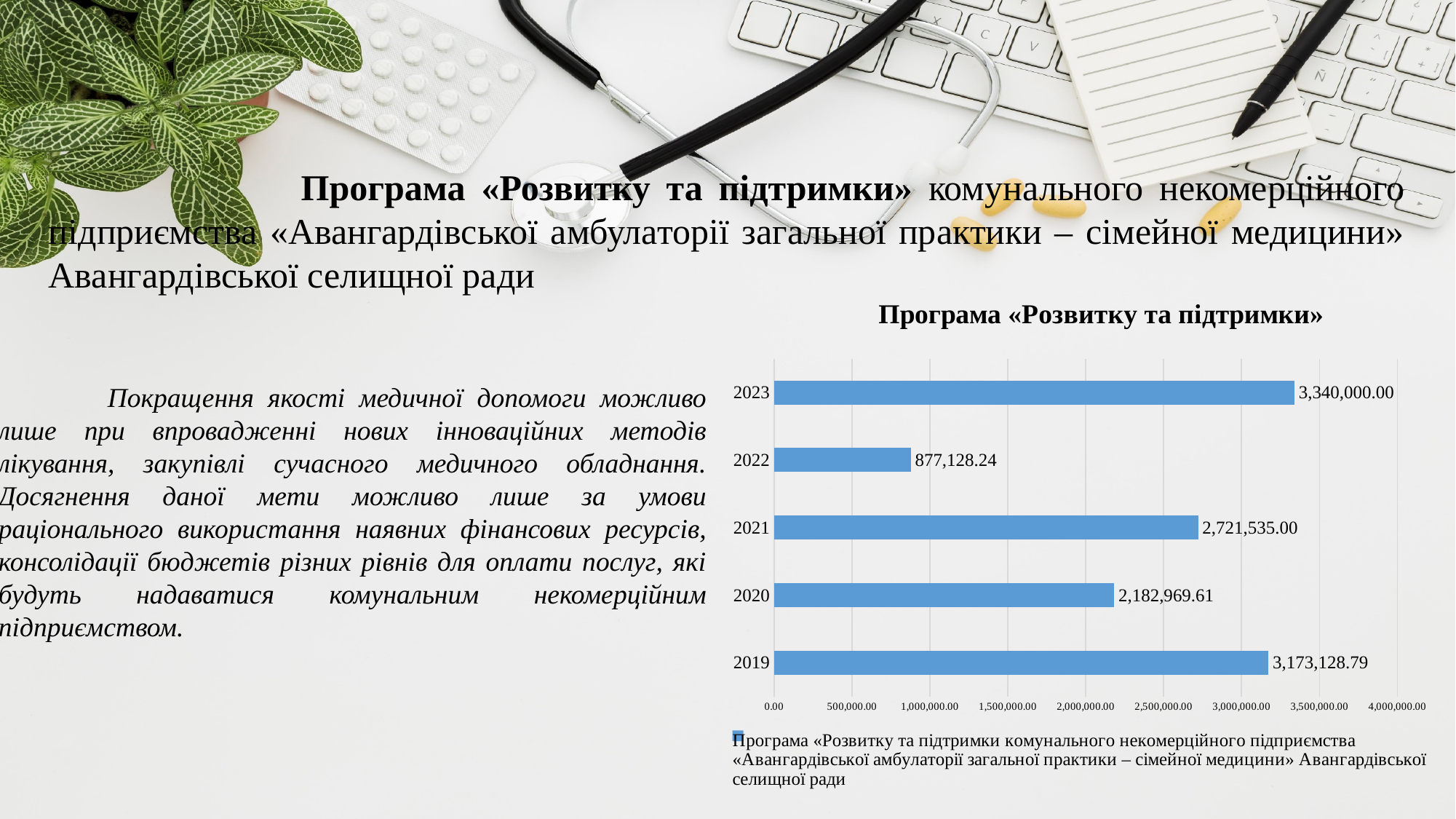
How many years are shown in the chart? 5 What is the value for 2023? 3,340,000.00 Is the value for 2019 greater or less than 3,000,000.00? greater What is the difference between the values for 2023 and 2019? 166,871.21 What is the difference between the values for 2021 and 2020? 538,565.39 Which year has the lowest value? 2022 Which year has the highest value? 2023 What type of chart is shown on the slide? bar chart What is the value for 2022? 877,128.24 Which is larger, the value for 2021 or the value for 2020? 2021 What is the title of the chart? Програма «Розвитку та підтримки» What is the value for 2020? 2,182,969.61